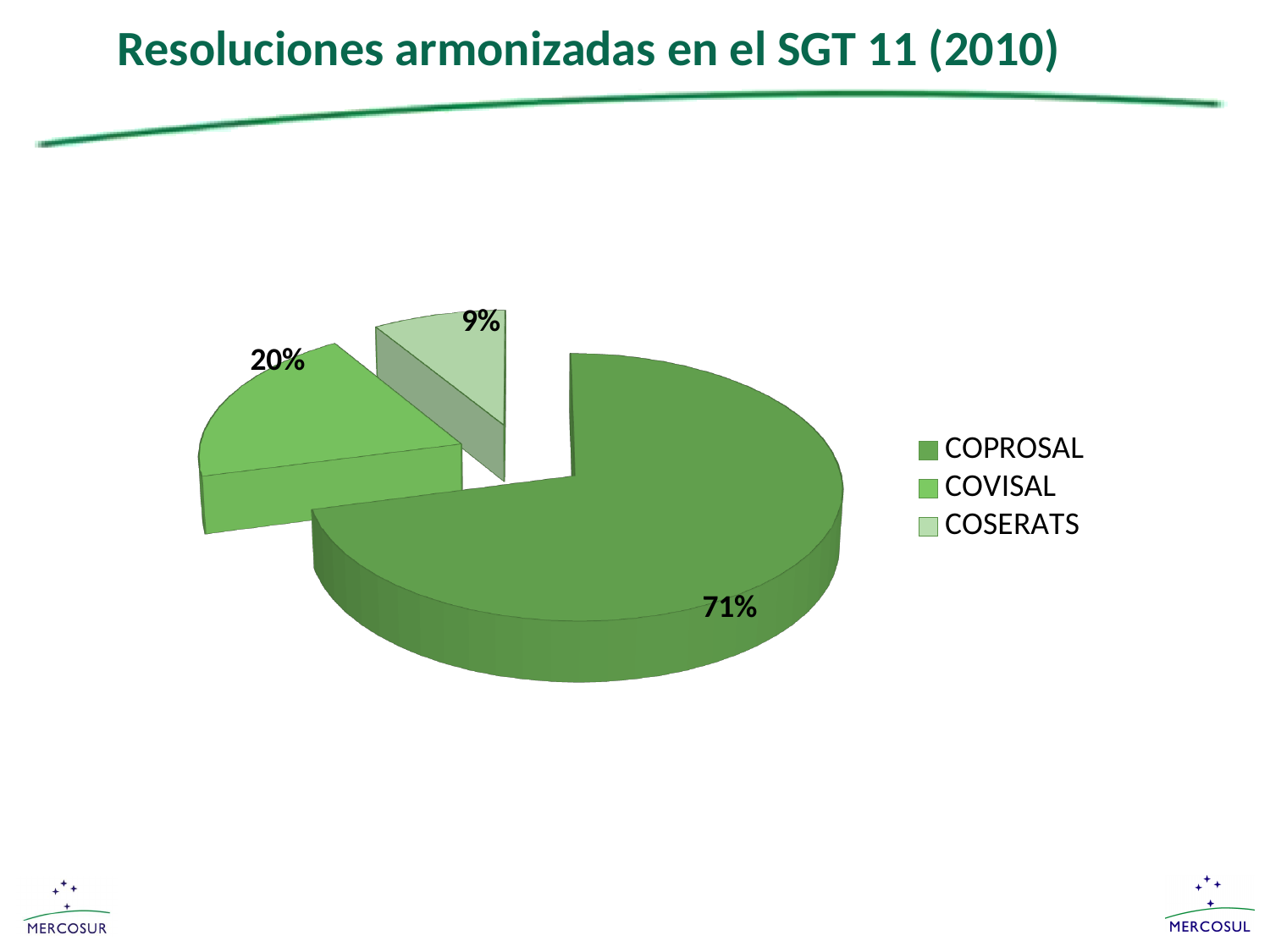
What share of the pie does COVISAL have? 20% What is the difference in percentage points between COPROSAL and COVISAL? 51 Which is larger, the COVISAL slice or the COSERATS slice? COVISAL How many categories are shown in the pie chart? 3 What share of the pie does COPROSAL have? 71% What kind of chart is shown on the slide? Pie chart What is the difference in percentage points between COVISAL and COSERATS? 11 Which legend entry is shown with the lightest green colour? COSERATS Which category has the largest slice of the pie? COPROSAL Which category has the smallest slice of the pie? COSERATS What share of the pie does COSERATS have? 9% What is the title of the slide containing the chart? Resoluciones armonizadas en el SGT 11 (2010)